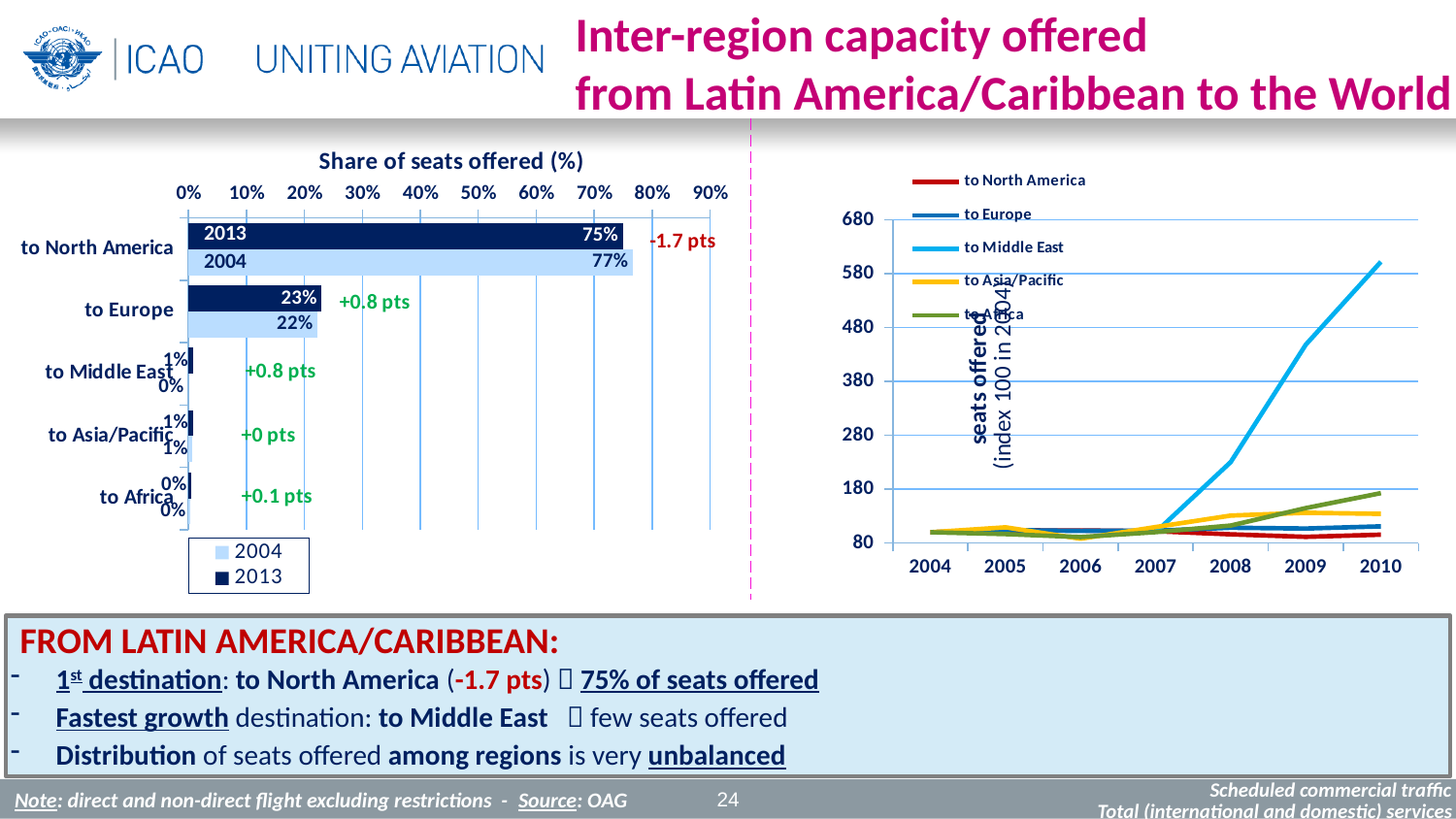
In the 'Share of seats offered (%)' chart, how many destination categories are shown? 5 In the line chart on the right, is the 2010 value for 'to Middle East' greater or less than 580? greater In the 'Share of seats offered (%)' chart, what is the 2013 share for 'to North America'? 75% In the 'Share of seats offered (%)' chart, which is larger: the 2013 share for 'to Europe' or the 2004 share for 'to Europe'? 2013 (23%) In the 'Share of seats offered (%)' chart, what is the 2004 share for 'to North America'? 77% What kind of chart is the chart on the right side of the slide? Line chart In the 'Share of seats offered (%)' chart, what is the 2004 share for 'to Europe'? 22% In the line chart on the right, how many series does the legend list? 5 In the 'Share of seats offered (%)' chart, which destination has the highest share of seats offered in 2013? to North America In the 'Share of seats offered (%)' chart, what is the difference between the 2004 and 2013 shares for 'to North America'? 2% In the 'Share of seats offered (%)' chart, how many series does the legend list? 2 In the 'Share of seats offered (%)' chart, what is the 2013 share for 'to Europe'? 23%